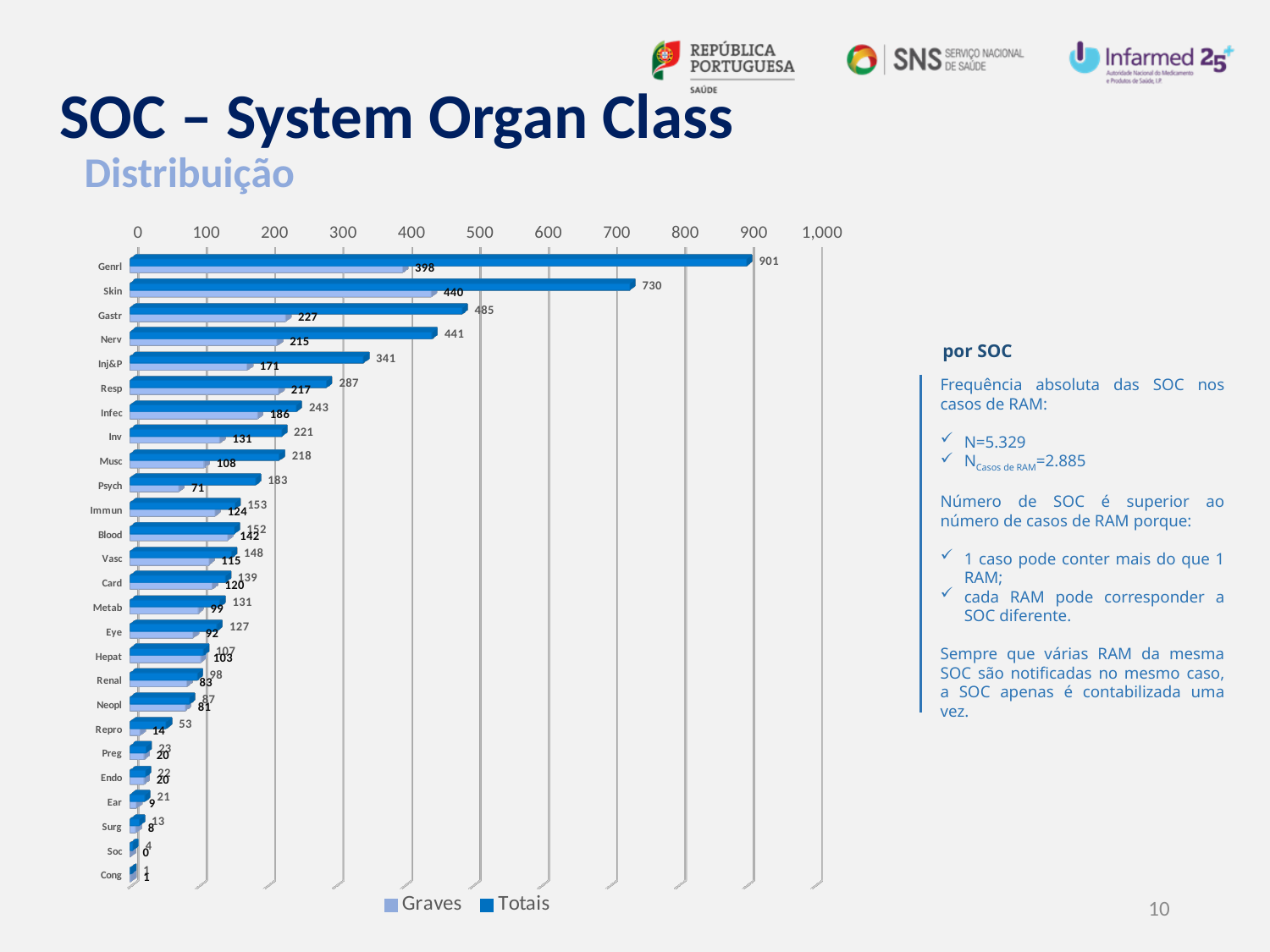
Which category has the lowest Totais value? Cong What is the Totais value for Inj&P? 341 What is the Graves value for Skin? 440 Which category has the highest Totais value? Genrl What is the Totais value for Genrl? 901 What kind of chart is shown on the slide? bar chart What is the Graves value for Psych? 71 What is the difference between the Totais and Graves values for Gastr? 258 How many series does the legend list? 2 Is the Totais value for Skin greater or less than 700? greater Which is larger, the Totais value for Resp or the Totais value for Infec? Resp How many categories are shown on the chart? 26